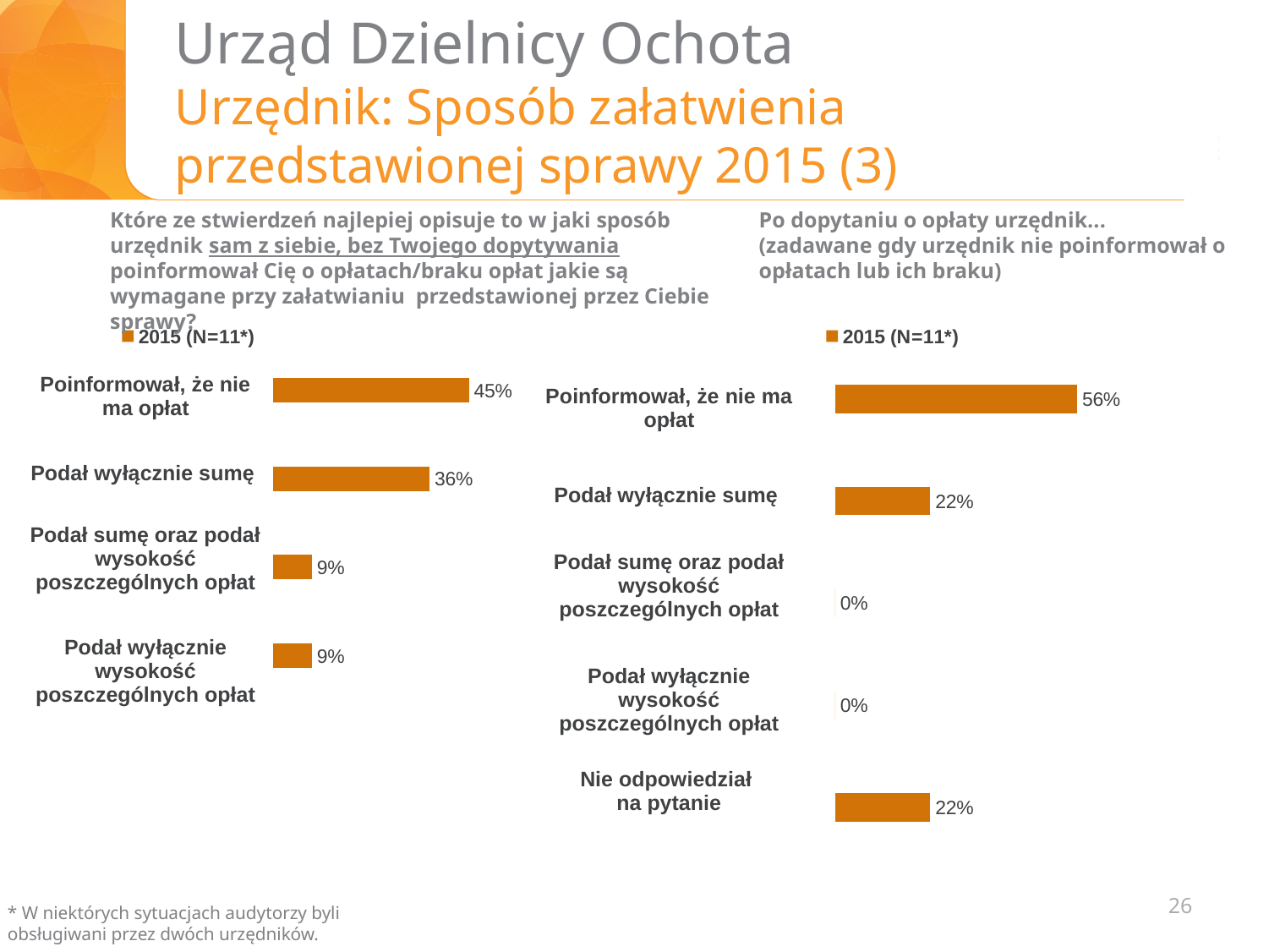
In the right chart, what is the value for "Nie odpowiedział na pytanie"? 22% In the left chart, which category has the highest value? Poinformował, że nie ma opłat How many categories does the left chart show? 4 In the left chart, what is the value for "Podał wyłącznie sumę"? 36% Which is larger: "Podał wyłącznie sumę" in the left chart or "Podał wyłącznie sumę" in the right chart? Left chart In the right chart, which category has the highest value? Poinformował, że nie ma opłat In the left chart, what is the difference between "Poinformował, że nie ma opłat" and "Podał wyłącznie sumę"? 9% How many categories does the right chart show? 5 In the right chart, what is the difference between "Poinformował, że nie ma opłat" and "Podał wyłącznie sumę"? 34% In the left chart, what is the value for "Poinformował, że nie ma opłat"? 45% What type of chart is the left chart? Bar chart In the right chart, what is the value for "Poinformował, że nie ma opłat"? 56%